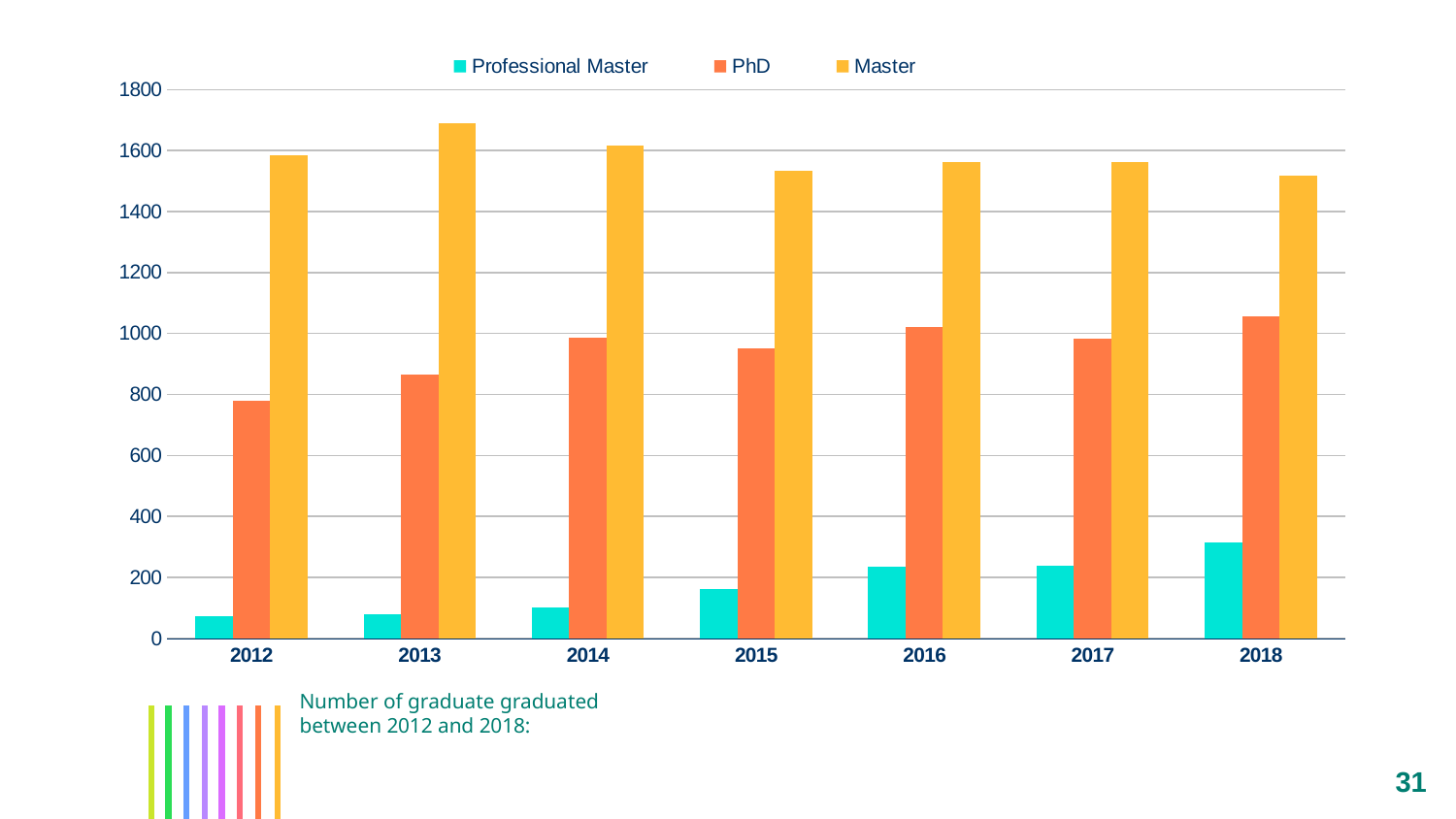
In which year is the PhD series lowest? 2012 Is the value for Professional Master in 2018 greater or less than 300? greater How many series does the legend list? 3 How many years are shown on the x axis? 7 Which is larger, the PhD value in 2013 or the PhD value in 2014? 2014 Is the value for Master in 2018 greater or less than 1600? less In which year is the Master series highest? 2013 What kind of chart is shown on the slide? bar chart In which year is the Professional Master series highest? 2018 Does the Professional Master series generally rise or fall from 2012 to 2018? rise Is the value for PhD in 2012 greater or less than 800? less